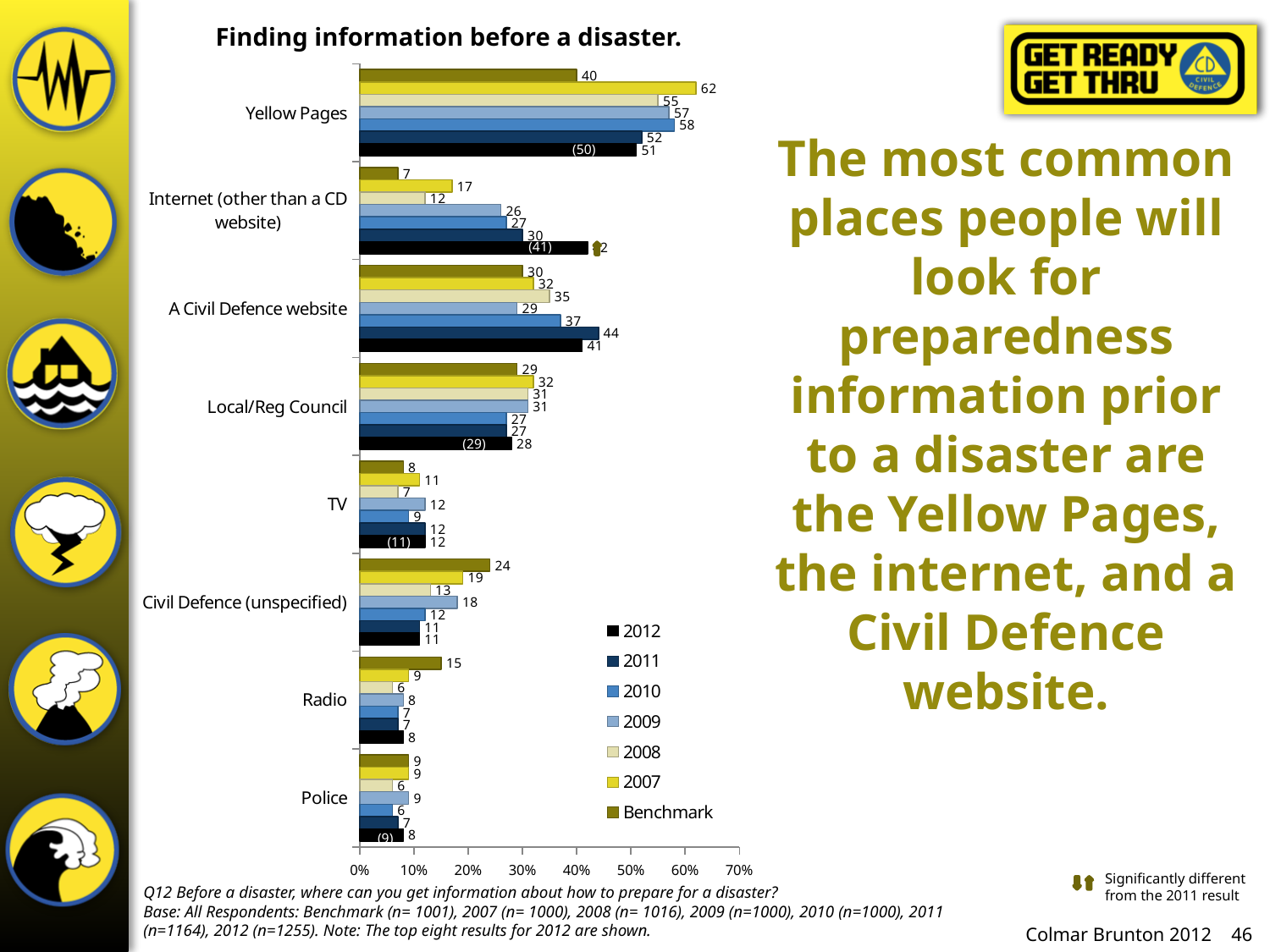
How many series does the legend list? 7 Which category has the lowest Benchmark value? Internet (other than a CD website) Which category has the highest 2012 value? Yellow Pages How many categories are shown on the chart? 8 What is the 2012 value for Local/Reg Council? 28 What kind of chart is shown on the slide? Bar chart What is the 2007 value for Yellow Pages? 62 What is the 2011 value for A Civil Defence website? 44 What is the difference between the 2007 and 2012 values for Yellow Pages? 11 What is the Benchmark value for Civil Defence (unspecified)? 24 Which is larger for A Civil Defence website: the 2010 value or the 2011 value? 2011 Is the 2012 value for Yellow Pages greater or less than 40%? greater